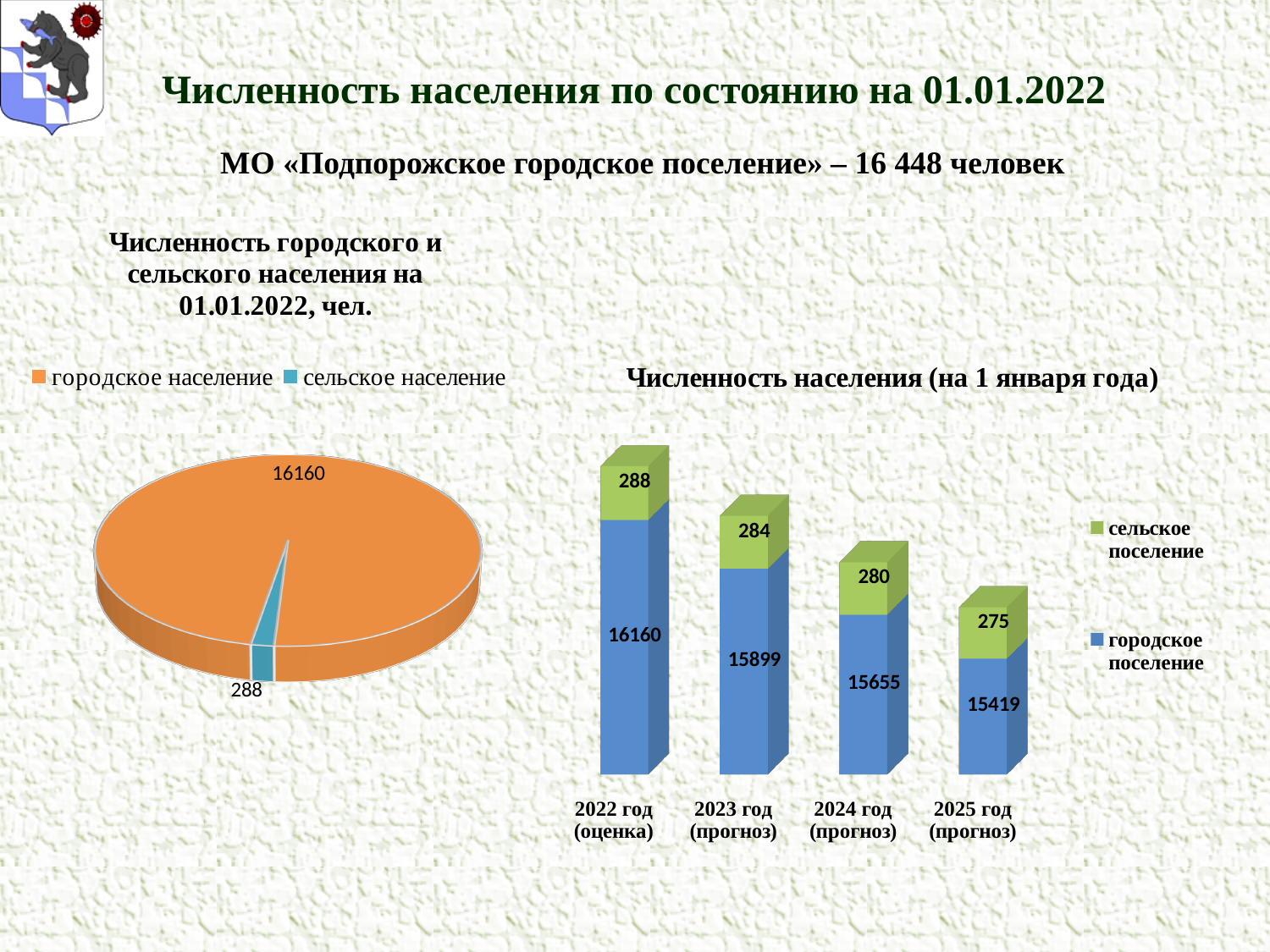
In the chart titled 'Численность населения (на 1 января года)', do the городское поселение values rise or fall from 2022 to 2025? fall In the chart titled 'Численность населения (на 1 января года)', how many year categories are shown on the x axis? 4 In the pie chart on the left, what is the difference between the городское население and сельское население values? 15872 In the chart titled 'Численность населения (на 1 января года)', what is the total of the stacked bar for 2024 год (прогноз)? 15935 In the chart titled 'Численность населения (на 1 января года)', what is the value for городское поселение in 2023 год (прогноз)? 15899 In the chart titled 'Численность населения (на 1 января года)', which year has the lowest value for городское поселение? 2025 год (прогноз) In the pie chart on the left, which slice is larger, городское население or сельское население? городское население In the chart titled 'Численность населения (на 1 января года)', how many series does the legend list? 2 What type of chart is the chart on the left of the slide? pie chart In the pie chart on the left, what is the value for городское население? 16160 In the chart titled 'Численность населения (на 1 января года)', what is the value for сельское поселение in 2025 год (прогноз)? 275 In the pie chart on the left, what is the value for сельское население? 288